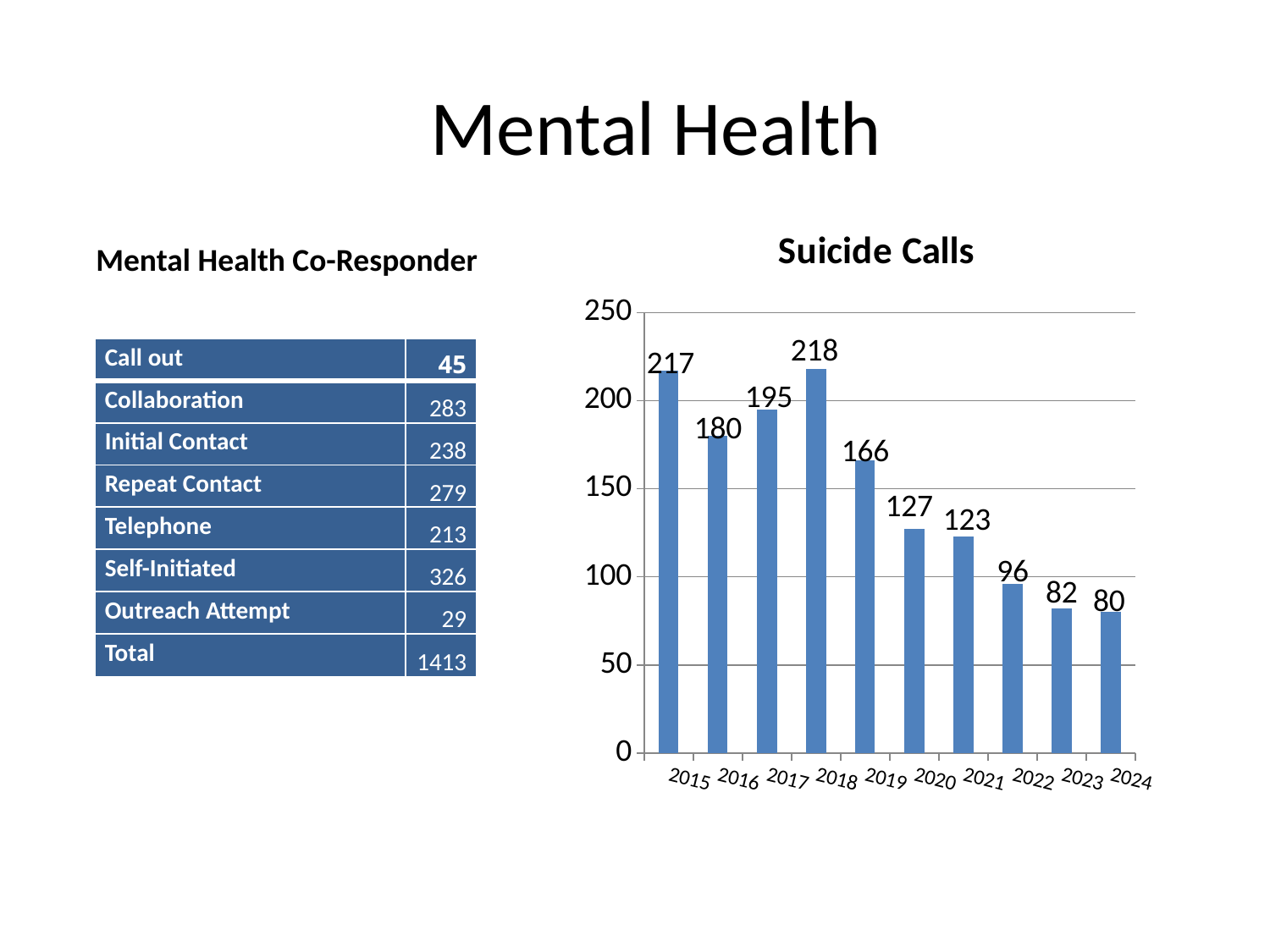
Is the value for 2021 in the Suicide Calls chart greater or less than 100? less How many years are plotted in the Suicide Calls chart? 10 Which is larger in the Suicide Calls chart, the value for 2016 or the value for 2017? 2017 What is the title of the chart on the slide? Suicide Calls Which year has the lowest value in the Suicide Calls chart? 2024 What is the difference between the values for 2018 and 2019 in the Suicide Calls chart? 52 Which year has the highest value in the Suicide Calls chart? 2018 What is the value for 2024 in the Suicide Calls chart? 80 Do the values in the Suicide Calls chart generally rise or fall from 2018 to 2024? fall What type of chart is used to show Suicide Calls? bar chart What is the value for 2020 in the Suicide Calls chart? 127 What is the value for 2015 in the Suicide Calls chart? 217